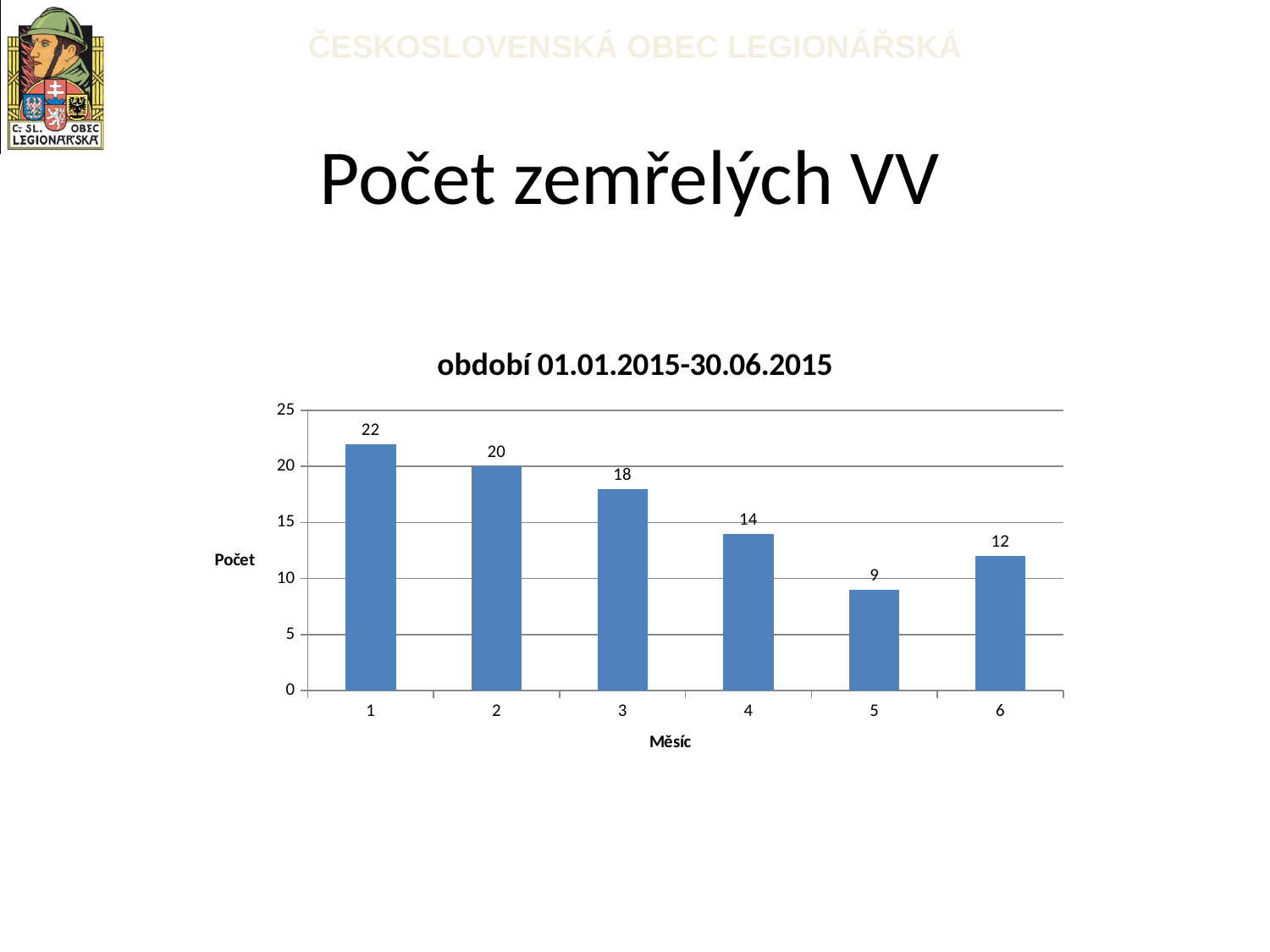
Is the value for month 3 greater or less than 15? greater What is the value for month 6? 12 What is the value for month 1? 22 How many months are shown on the x axis? 6 What kind of chart is shown on the slide? bar chart What is the title of the chart? období 01.01.2015-30.06.2015 Which is larger, the value for month 2 or the value for month 4? month 2 Which month has the highest value? 1 Which month has the lowest value? 5 What is the difference between the values for month 3 and month 4? 4 What is the difference between the values for month 1 and month 6? 10 What is the value for month 5? 9